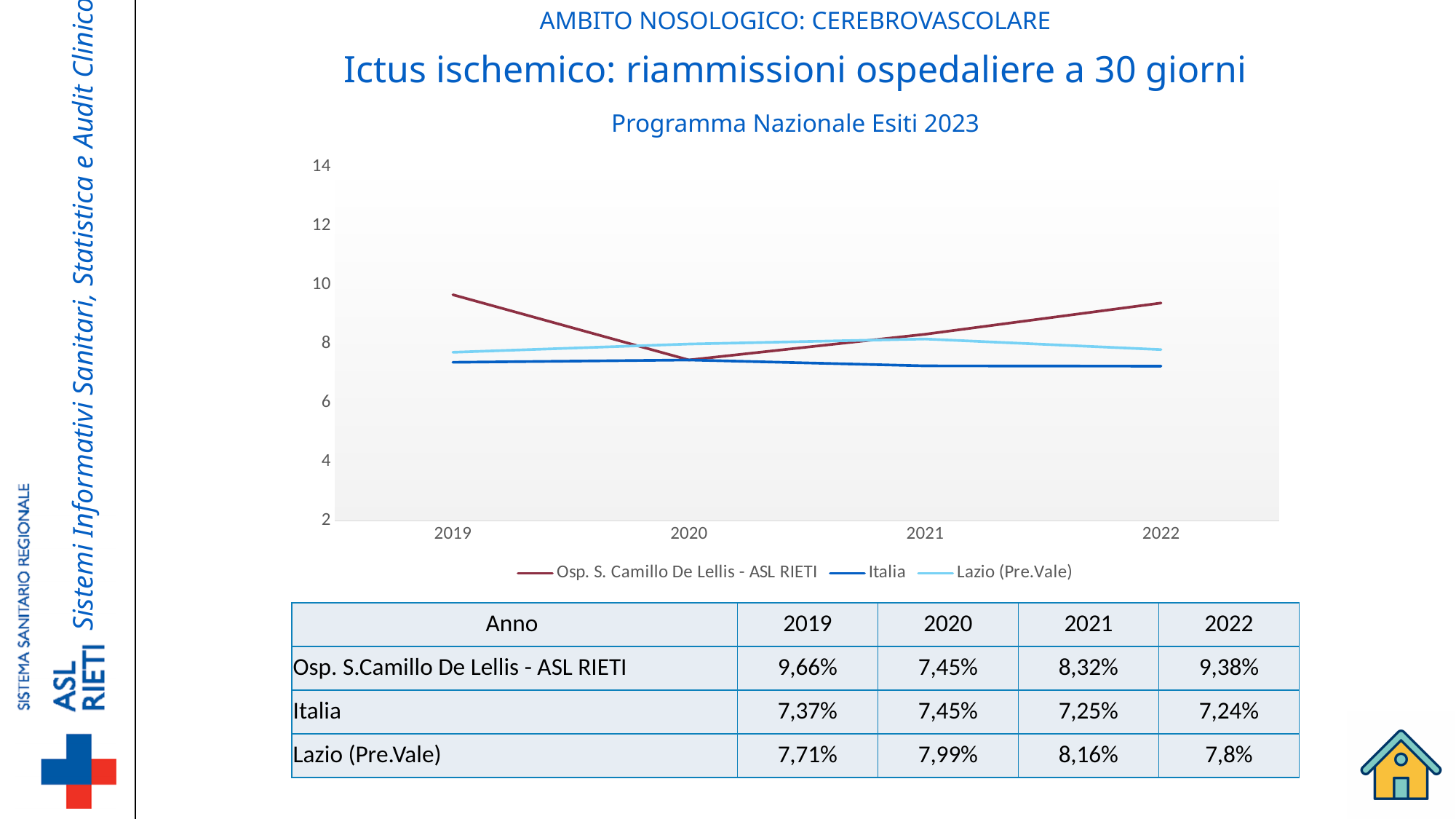
What kind of chart is shown on the slide? line chart Does the value for Italia rise or fall from 2020 to 2022? fall What is the value for Osp. S. Camillo De Lellis - ASL RIETI in 2019? 9,66% How many series does the chart legend list? 3 How many years are plotted along the x axis of the chart? 4 In 2021, which is larger: the value for Lazio (Pre.Vale) or the value for Italia? Lazio (Pre.Vale) What is the difference between the 2022 values for Osp. S. Camillo De Lellis - ASL RIETI and Italia? 2,14% Is the value for Osp. S. Camillo De Lellis - ASL RIETI in 2019 greater or less than 8? greater What is the value for Lazio (Pre.Vale) in 2021? 8,16% What is the value for Italia in 2022? 7,24% In which year is the value for Osp. S. Camillo De Lellis - ASL RIETI highest? 2019 In which year is the value for Osp. S. Camillo De Lellis - ASL RIETI lowest? 2020